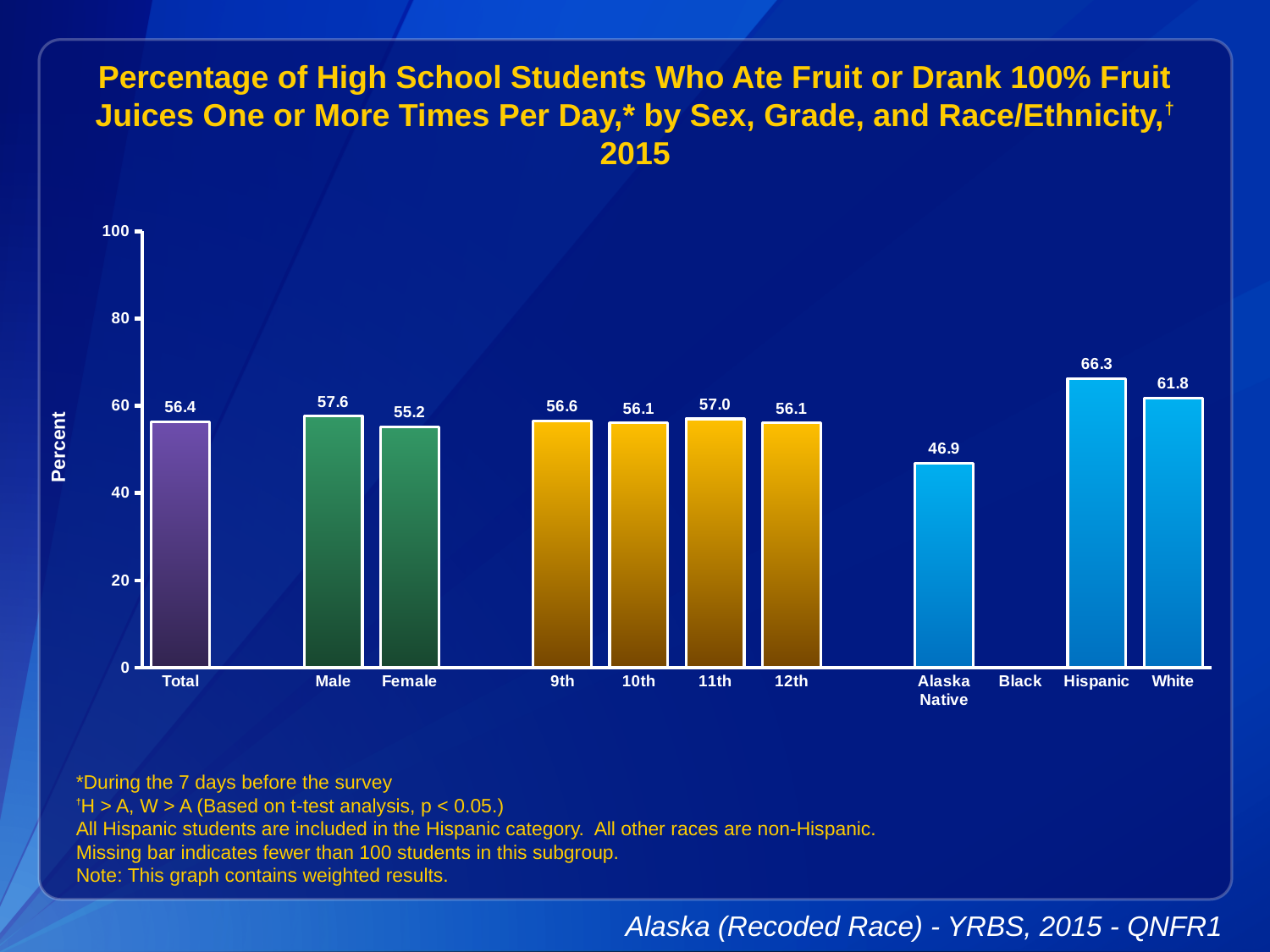
What is the value for Alaska Native? 46.9 What is the difference between the Hispanic and White values? 4.5 Which category label has no bar shown? Black Which category has the highest value? Hispanic What is the difference between the Male and Female values? 2.4 What is the value for Total? 56.4 What kind of chart is shown on the slide? bar chart What is the value for Female? 55.2 Which is larger, the value for 9th grade or the value for 12th grade? 9th Which category has the lowest value among those with a bar shown? Alaska Native Is the value for Alaska Native greater or less than 60? less What is the value for 11th grade? 57.0